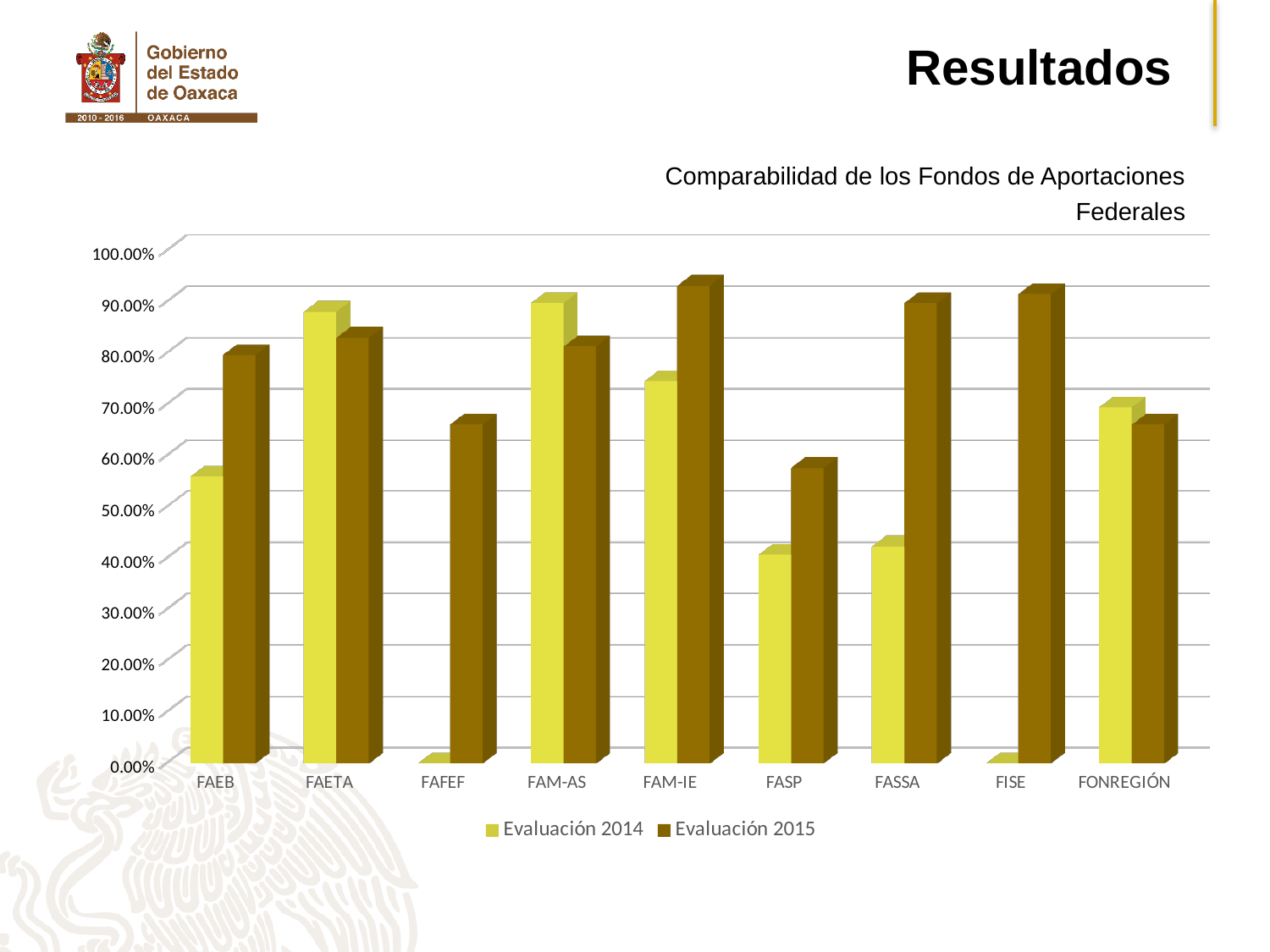
For FAEB, which is larger: Evaluación 2014 or Evaluación 2015? Evaluación 2015 Is the Evaluación 2014 value for FAEB greater or less than 50.00%? greater What kind of chart is shown on the slide? bar chart Which category has the lowest value for Evaluación 2015? FASP Is the Evaluación 2015 value for FISE greater or less than 80.00%? greater How many categories are shown on the x axis? 9 Which series does the legend list second? Evaluación 2015 Is the Evaluación 2015 value for FASP greater or less than 60.00%? less What is the title of the chart? Comparabilidad de los Fondos de Aportaciones Federales For FASSA, which is larger: Evaluación 2014 or Evaluación 2015? Evaluación 2015 How many series does the legend list? 2 For FAM-AS, which is larger: Evaluación 2014 or Evaluación 2015? Evaluación 2014